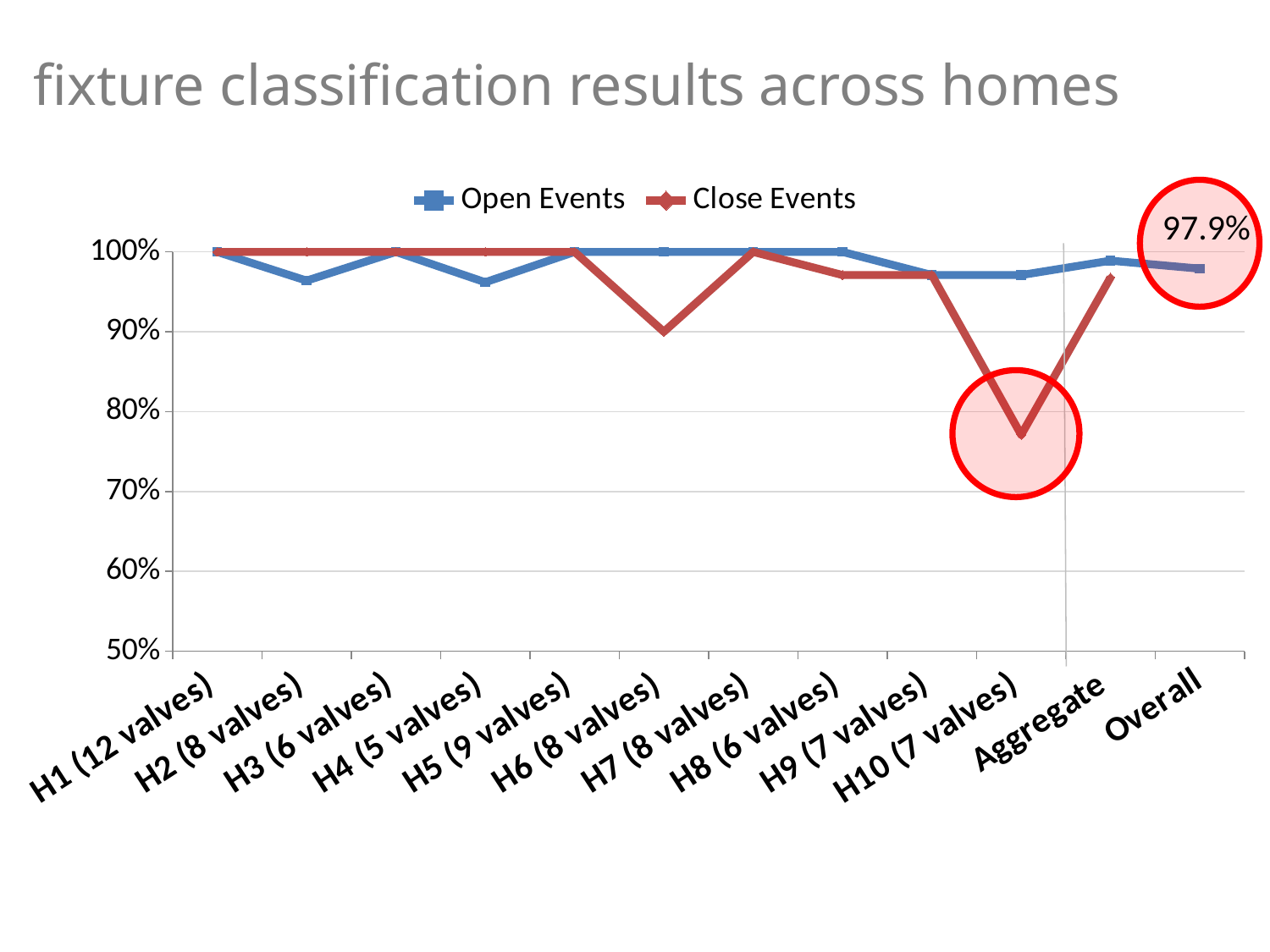
Which category has the lowest value for Close Events? H10 (7 valves) At H10 (7 valves), which series has the larger value, Open Events or Close Events? Open Events How many series does the legend list? 2 What kind of chart is shown on the slide? line chart Is the value for Open Events at H2 (8 valves) greater or less than 90%? greater Is the value for Close Events at H10 (7 valves) greater or less than 80%? less How many categories are shown along the x axis? 12 What value is printed in the red circle near the Overall category? 97.9% What is the title of the chart? fixture classification results across homes What is the value for Open Events at H1 (12 valves)? 100% Is the value for Close Events at H6 (8 valves) greater or less than 80%? greater What is the value for Close Events at H5 (9 valves)? 100%